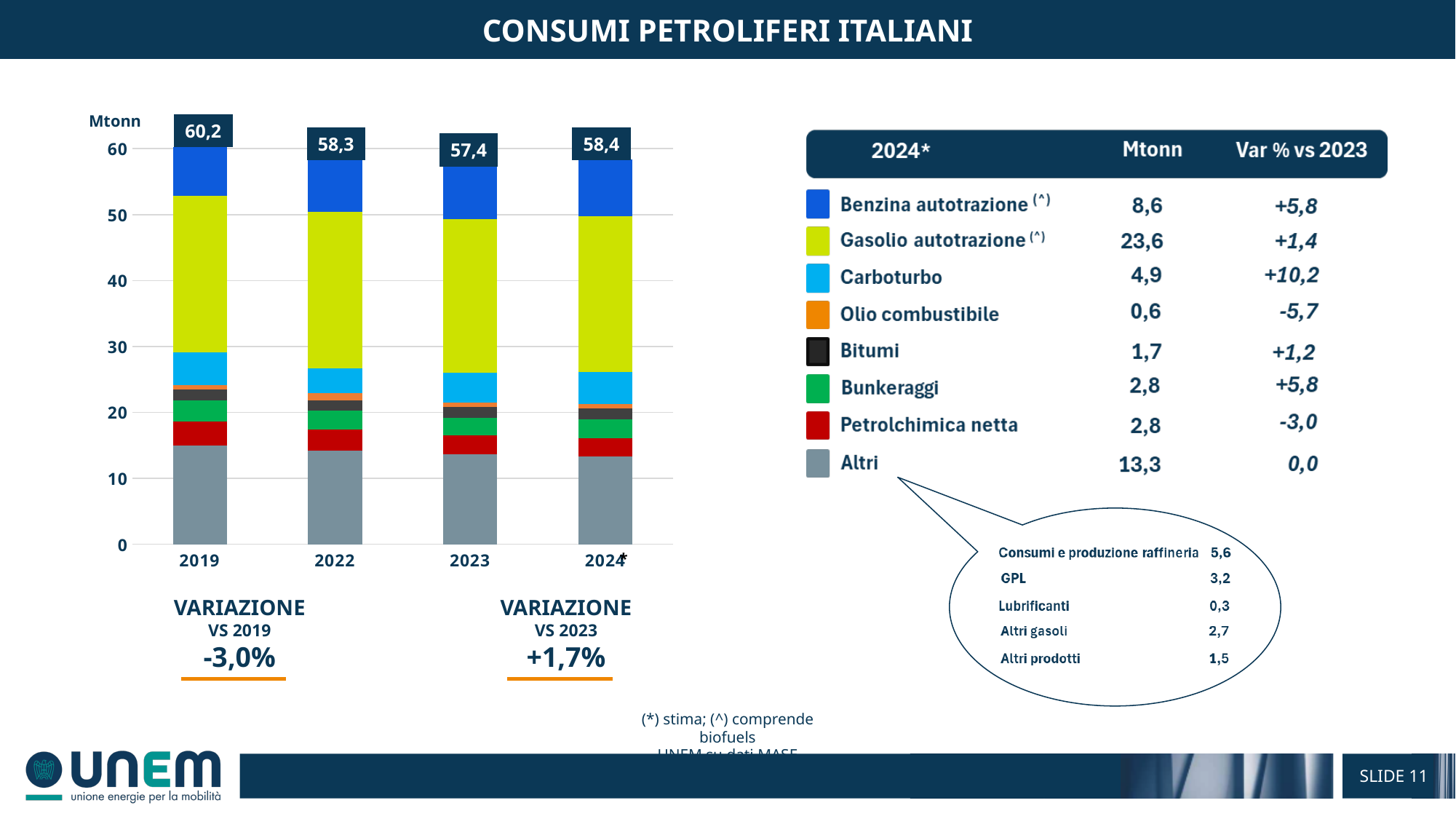
Which year has the highest total consumption in the bar chart? 2019 Is the top of the 2019 bar greater or less than 50? greater How many product series are listed in the legend table next to the chart? 8 What is the total value shown on top of the 2019 bar? 60,2 Which year has the lowest total consumption in the bar chart? 2023 What is the total value shown on top of the 2024* bar? 58,4 What unit is shown on the y axis of the chart? Mtonn What is the difference between the 2024* total and the 2023 total? 1,0 What is the difference between the 2019 total and the 2023 total? 2,8 Which is larger, the total for 2022 or the total for 2024*? 2024* What kind of chart is shown on the slide? Stacked bar chart How many years (bars) are shown in the bar chart? 4